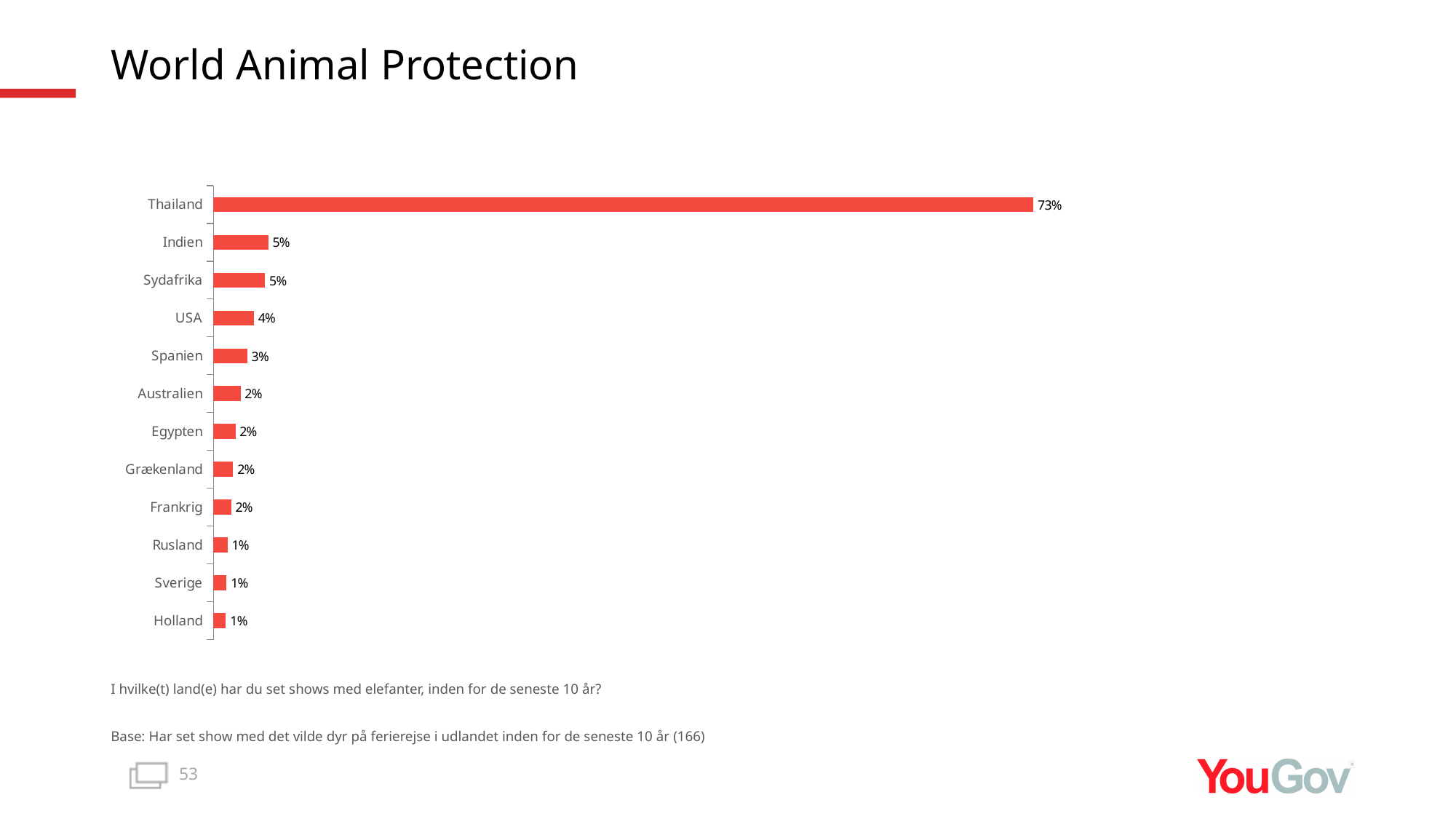
Which country has the highest value in the chart? Thailand Which has a larger value, USA or Rusland? USA What kind of chart is shown on the slide? Bar chart What is the difference between the values for Thailand and Indien? 68 percentage points What percentage is shown for Holland? 1% What is the difference between the values for USA and Spanien? 1 percentage point Which has a larger value, Thailand or Sydafrika? Thailand How many countries are shown in the chart? 12 What is the value for USA? 4% What is the title of the slide? World Animal Protection What value is shown for Spanien? 3% What percentage is shown for Thailand? 73%